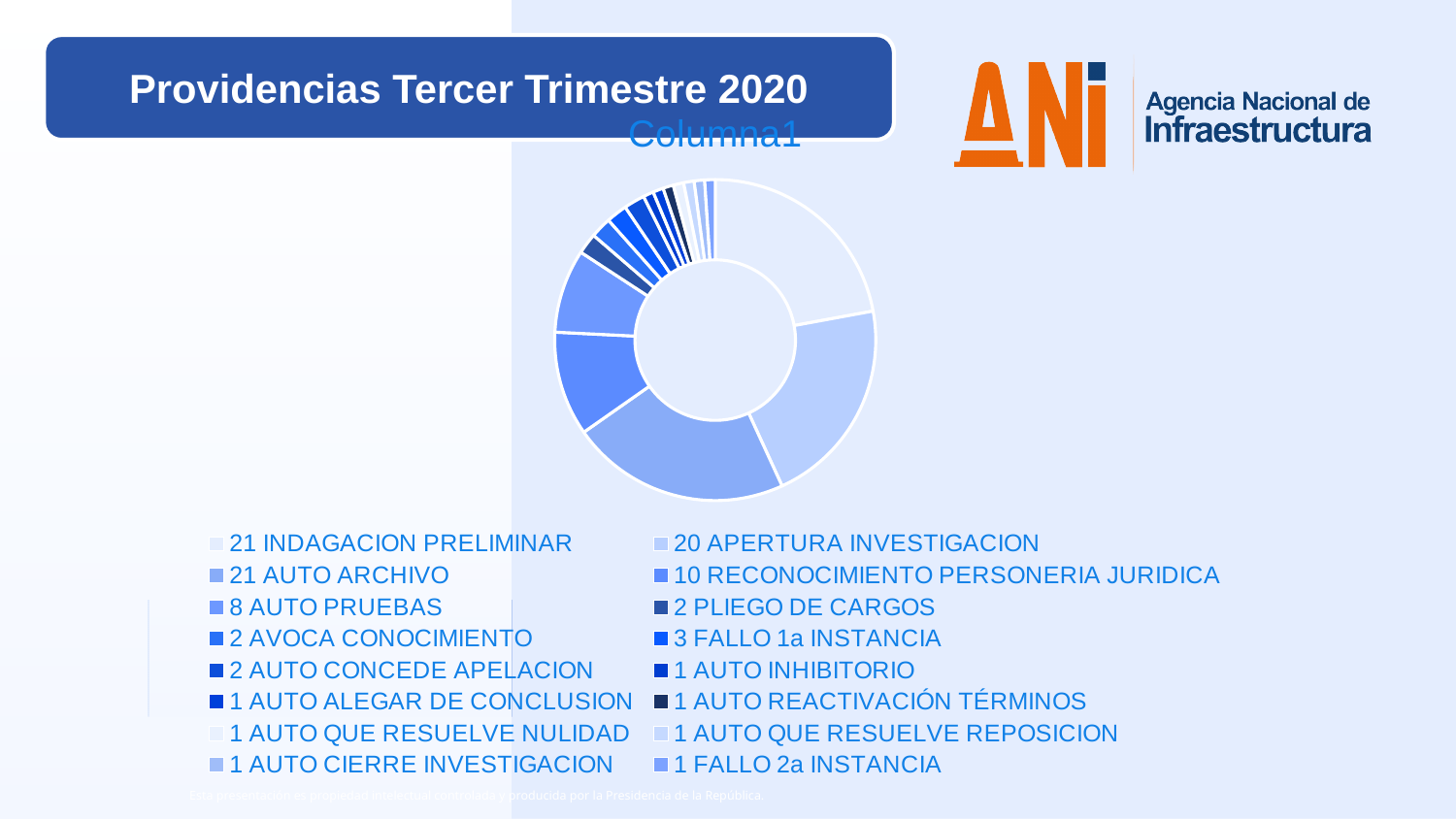
What is the value for APERTURA INVESTIGACION? 20 What is the value for RECONOCIMIENTO PERSONERIA JURIDICA? 10 What kind of chart is shown on the slide? Doughnut (pie) chart What is the value for FALLO 1a INSTANCIA? 3 What is the value for AUTO ARCHIVO? 21 What is the difference between the values for APERTURA INVESTIGACION and AUTO PRUEBAS? 12 Which is larger, APERTURA INVESTIGACION or AUTO PRUEBAS? APERTURA INVESTIGACION What is the value for AUTO PRUEBAS? 8 What is the difference between the values for AUTO ARCHIVO and RECONOCIMIENTO PERSONERIA JURIDICA? 11 Which is larger, RECONOCIMIENTO PERSONERIA JURIDICA or FALLO 1a INSTANCIA? RECONOCIMIENTO PERSONERIA JURIDICA How many categories does the chart's legend list? 16 What is the title shown above the chart? Columna1